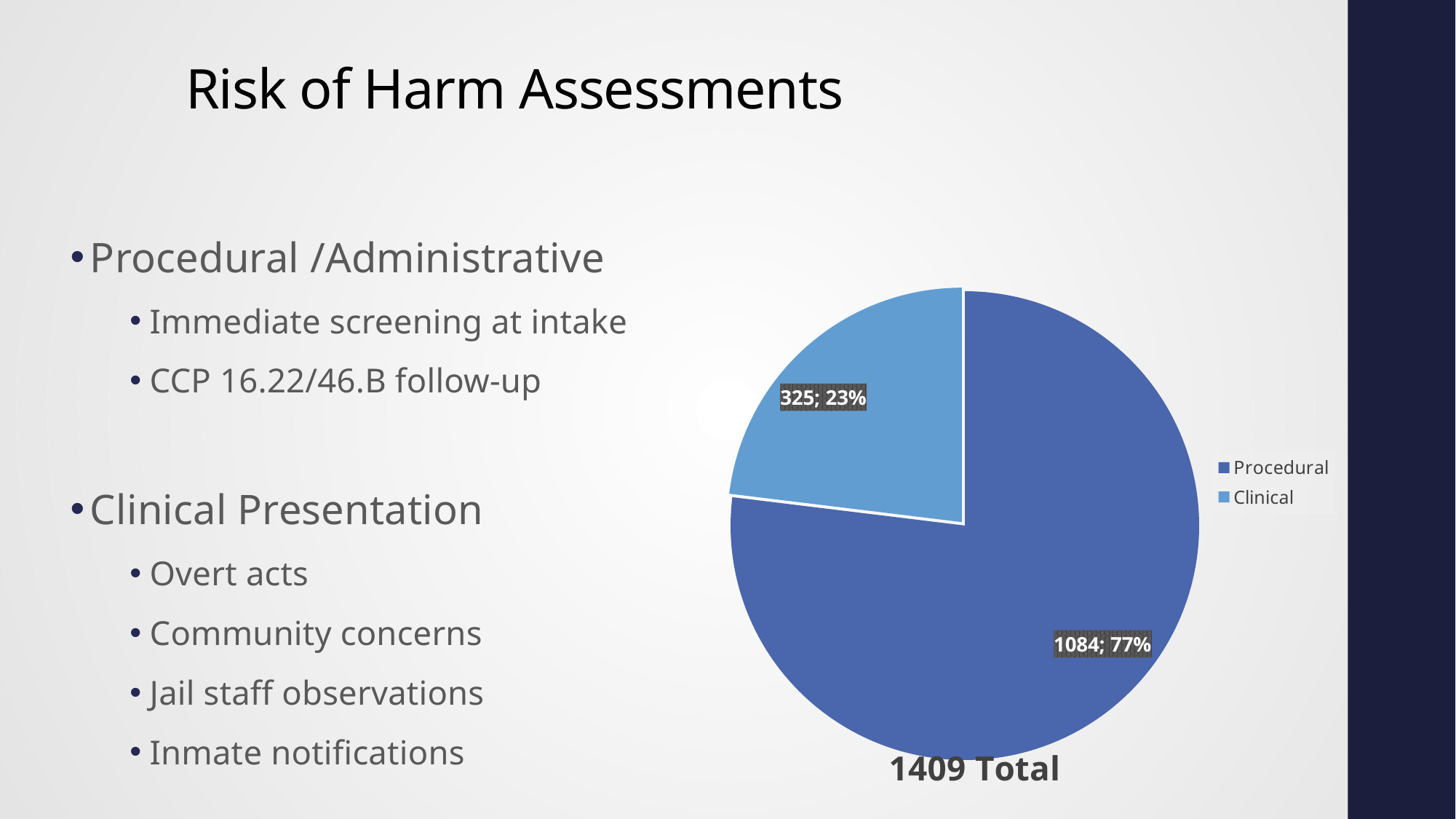
Which category has the smallest slice in the pie chart? Clinical What is the value for Procedural in the pie chart? 1084 What is the value for Clinical in the pie chart? 325 How many categories does the pie chart show? 2 What percentage share of the pie does the Clinical slice represent? 23% What total is printed below the pie chart? 1409 Total What kind of chart is shown on the slide? Pie chart What percentage share of the pie does the Procedural slice represent? 77% Which legend entry is shown in the lighter blue colour? Clinical Which category has the largest slice in the pie chart? Procedural What is the difference between the Procedural and Clinical values? 759 Which is larger, the Procedural value or the Clinical value? Procedural